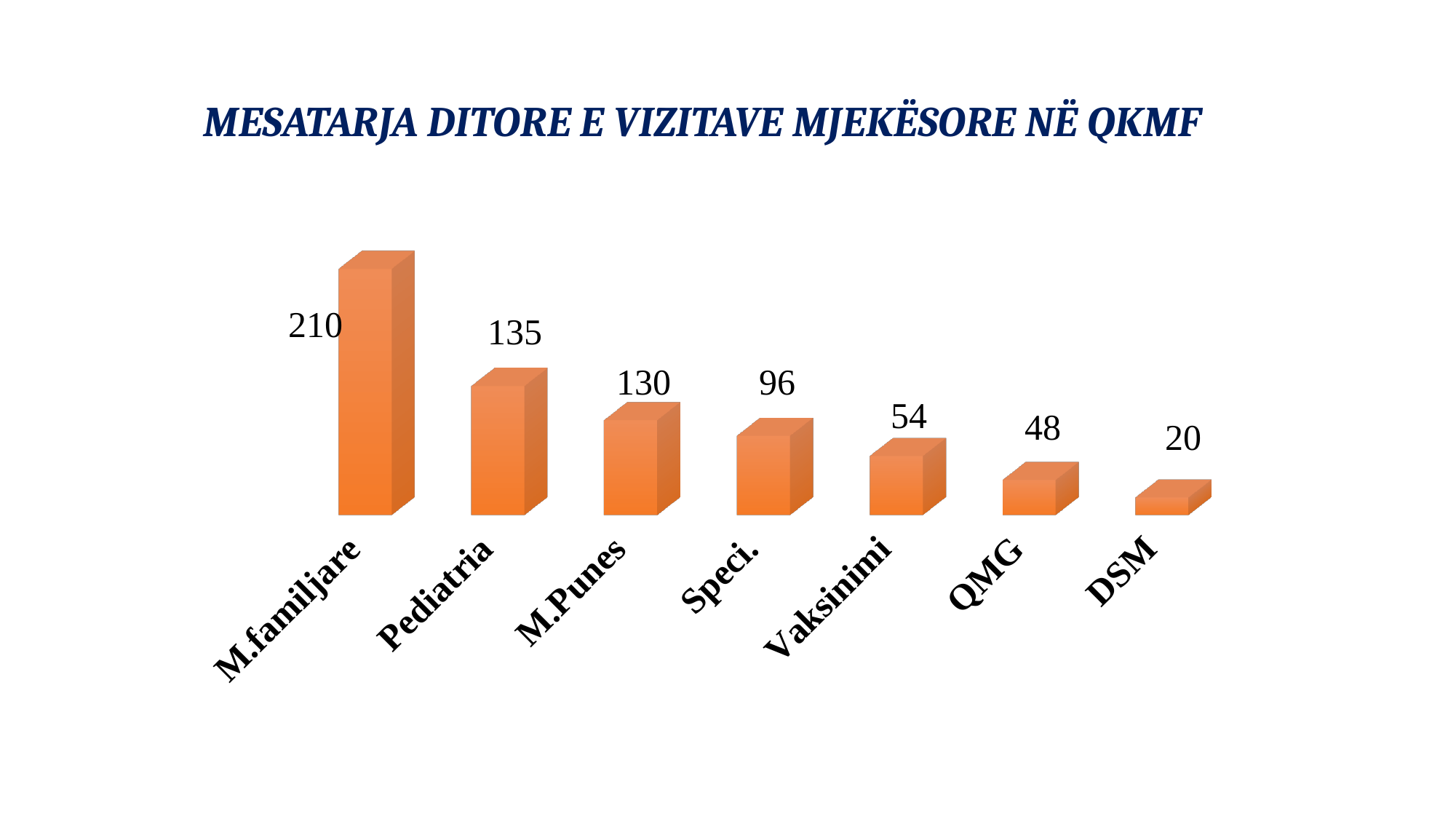
What is the difference between the values for M.familjare and Pediatria? 75 Which is larger, the value for M.Punes or the value for Speci.? M.Punes What is the difference between the values for Speci. and QMG? 48 What is the value for Vaksinimi? 54 How many categories are shown in the chart? 7 What kind of chart is shown on the slide? Bar chart What is the value for Pediatria? 135 Which category has the lowest value? DSM Do the values rise or fall from left to right along the x axis? Fall What is the value for M.familjare? 210 Which category has the highest value? M.familjare What is the value for DSM? 20